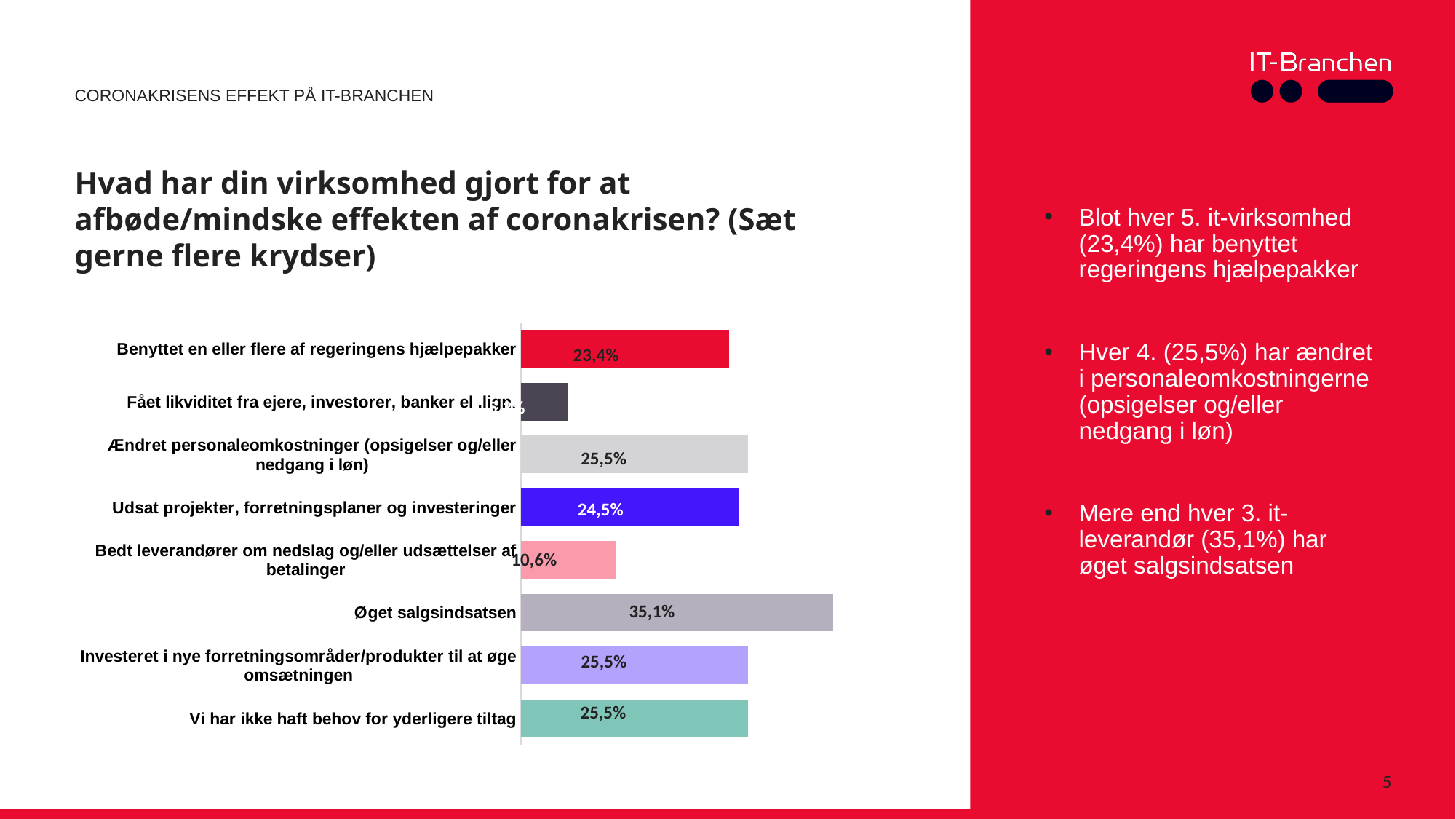
What is the value for "Udsat projekter, forretningsplaner og investeringer"? 24,5% How many categories does the chart show? 8 What colour is the bar for "Benyttet en eller flere af regeringens hjælpepakker"? Red Which category has the highest value? Øget salgsindsatsen What is the value for "Bedt leverandører om nedslag og/eller udsættelser af betalinger"? 10,6% What is the value for "Benyttet en eller flere af regeringens hjælpepakker"? 23,4% What kind of chart is shown on the slide? Bar chart What is the value for "Øget salgsindsatsen"? 35,1% What is the value for "Vi har ikke haft behov for yderligere tiltag"? 25,5% Which category has the lowest value? Fået likviditet fra ejere, investorer, banker el. lign. Which is larger: the value for "Ændret personaleomkostninger (opsigelser og/eller nedgang i løn)" or for "Udsat projekter, forretningsplaner og investeringer"? Ændret personaleomkostninger (opsigelser og/eller nedgang i løn) What is the difference between the values for "Øget salgsindsatsen" and "Benyttet en eller flere af regeringens hjælpepakker"? 11,7 percentage points